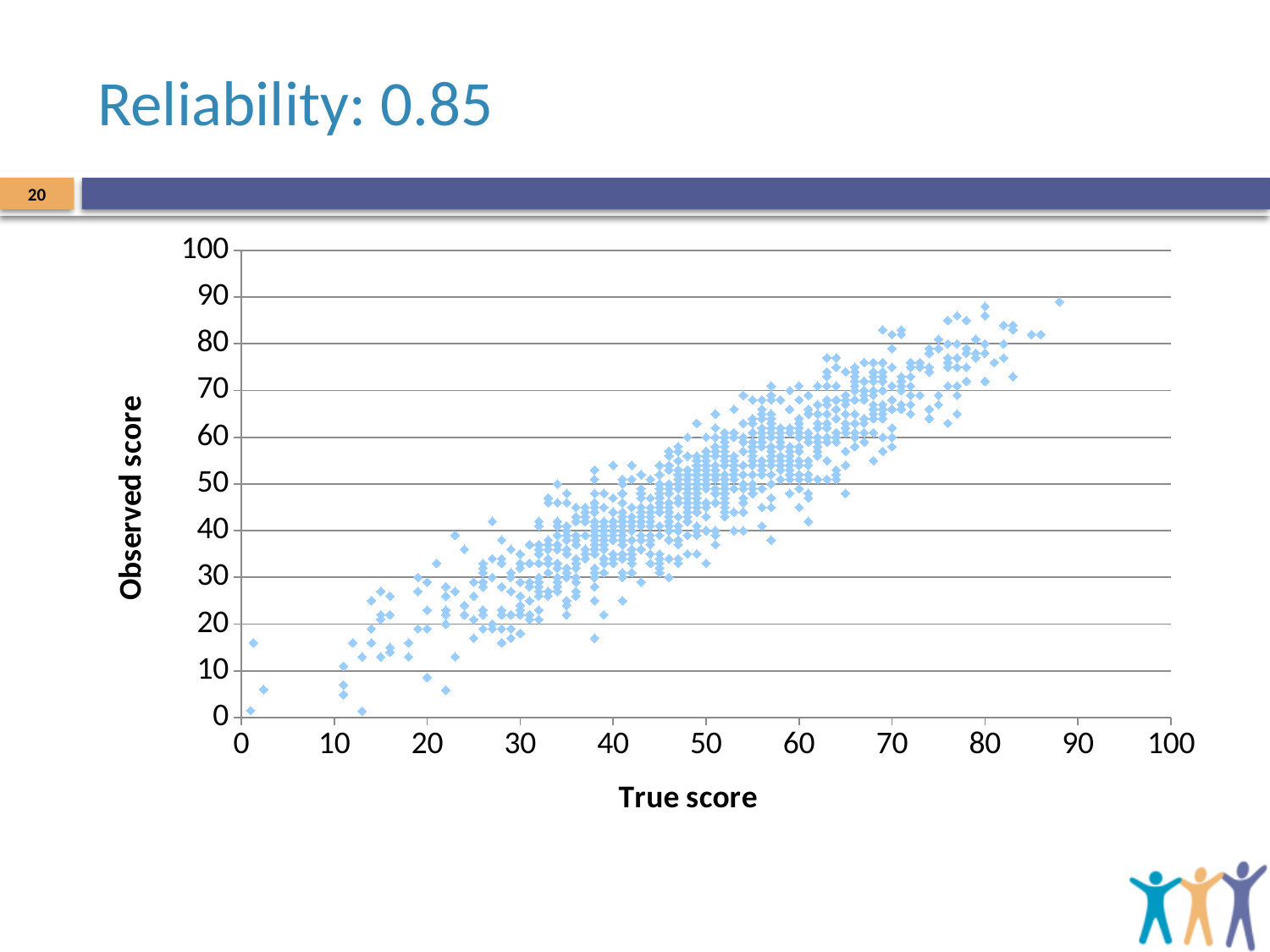
What is the label of the y axis? Observed score Is the lowest observed score plotted greater or less than 10? less Is the largest true score plotted greater or less than 90? less What is the label of the x axis? True score As the true score increases along the x axis, do the observed scores generally rise or fall? rise Is the highest observed score plotted greater or less than 80? greater What is the maximum value shown on the x axis? 100 What kind of chart is shown on the slide? scatter plot